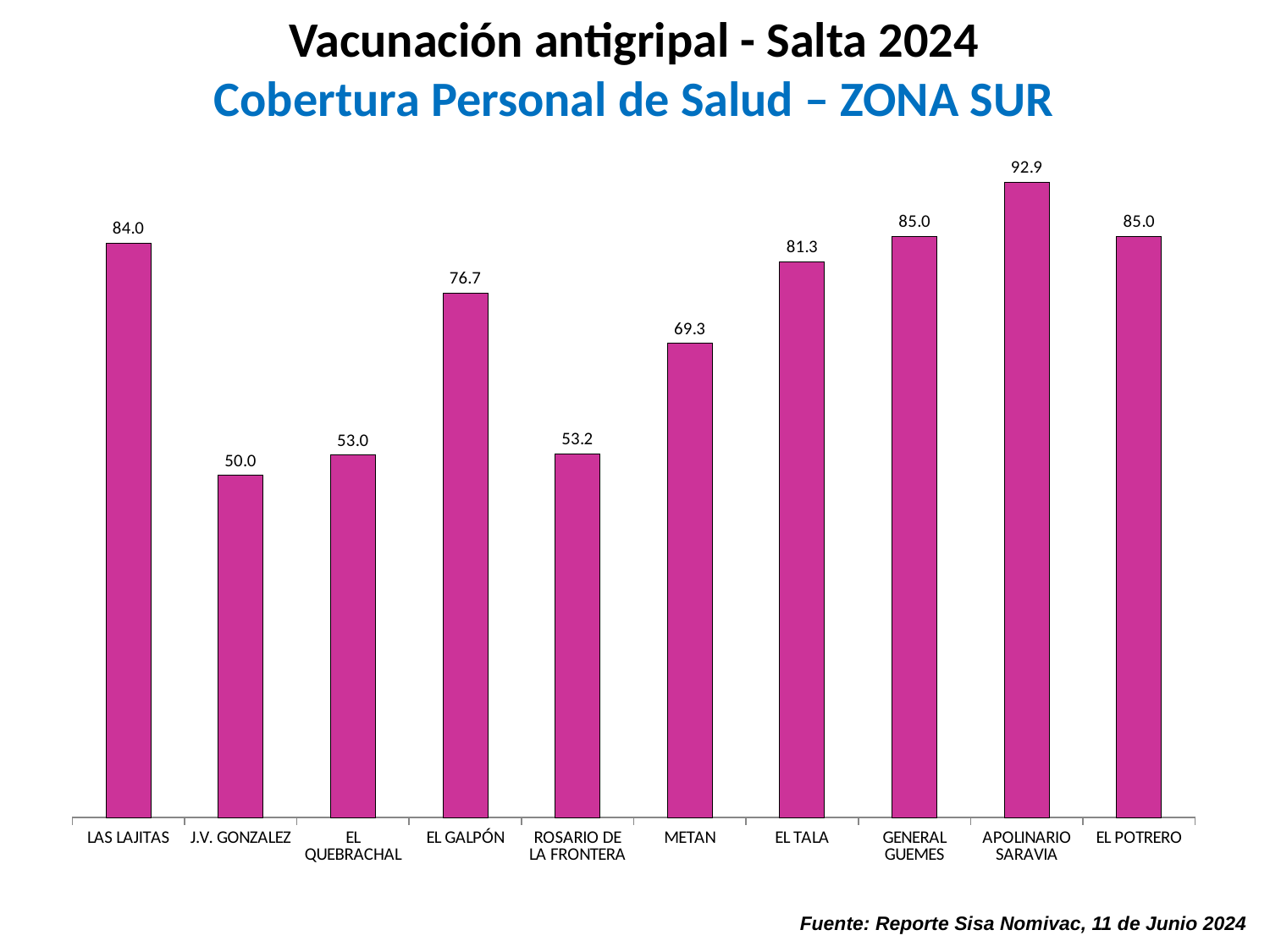
How many categories are shown on the x axis? 10 Which is larger, the value for EL GALPÓN or the value for EL TALA? EL TALA What is the value for EL GALPÓN? 76.7 What kind of chart is shown on the slide? Bar chart What is the value for METAN? 69.3 What is the difference between the values for EL TALA and METAN? 12.0 What source is cited at the bottom of the slide? Reporte Sisa Nomivac, 11 de Junio 2024 What is the subtitle of the chart shown in blue? Cobertura Personal de Salud – ZONA SUR What is the value for LAS LAJITAS? 84.0 Which category has the lowest value? J.V. GONZALEZ Which category has the highest value? APOLINARIO SARAVIA What is the difference between the values for APOLINARIO SARAVIA and J.V. GONZALEZ? 42.9